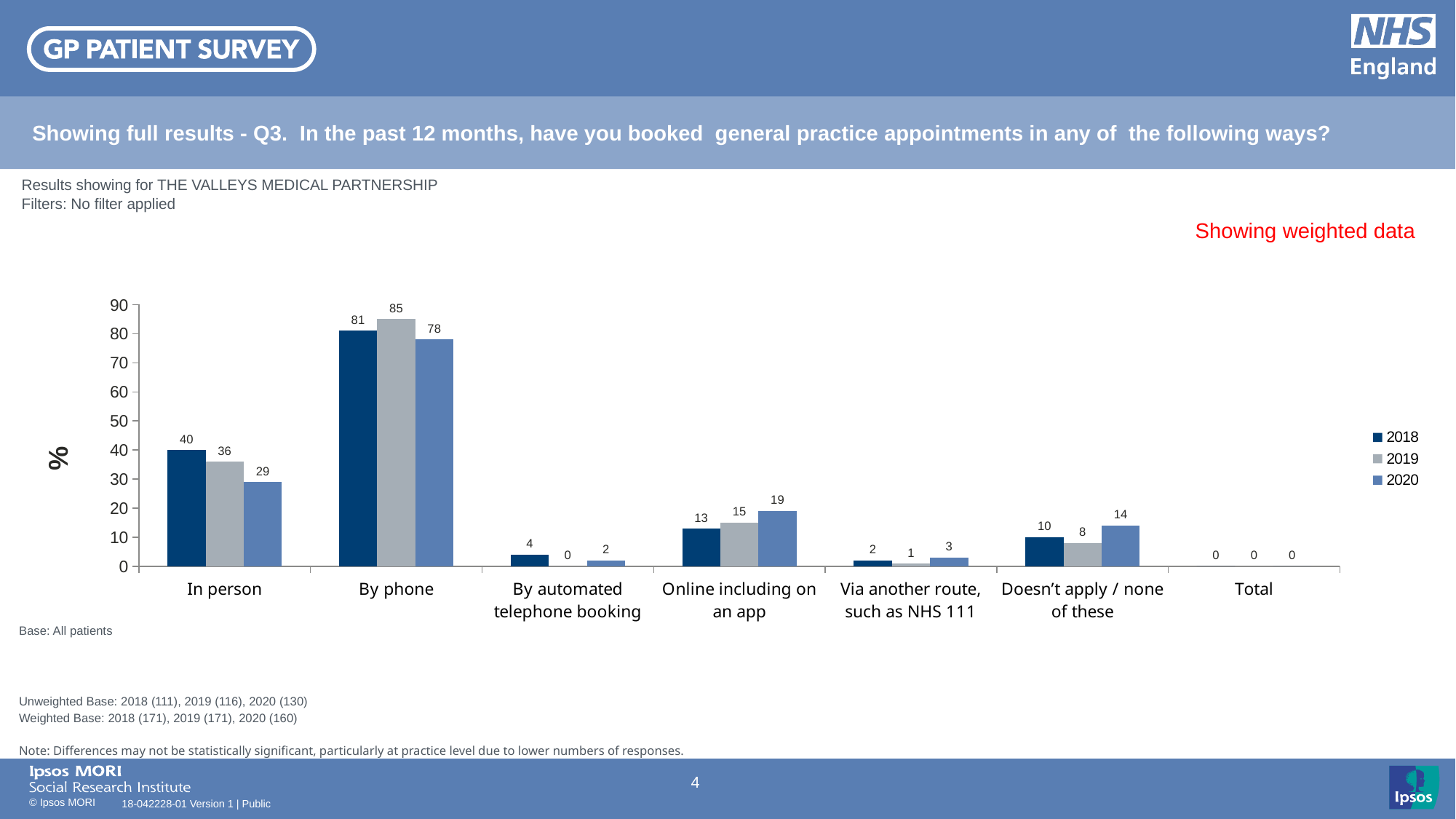
What is the value for 'Online including on an app' in 2018? 13 How many series does the legend list? 3 Which category has the highest value for 2020? By phone Is the 2020 value for 'By phone' greater or less than 70? greater What is the difference between the 2018 and 2020 values for 'In person'? 11 How many categories are shown on the x axis? 7 Which is larger: the 2019 value for 'Doesn't apply / none of these' or the 2020 value for 'Doesn't apply / none of these'? 2020 Which category has the lowest value for 2019, excluding 'Total'? By automated telephone booking Do the values for 'Online including on an app' rise or fall from 2018 to 2020? Rise What is the value for 'By phone' in 2019? 85 What kind of chart is shown on the slide? Bar chart What is the value for 'In person' in 2020? 29